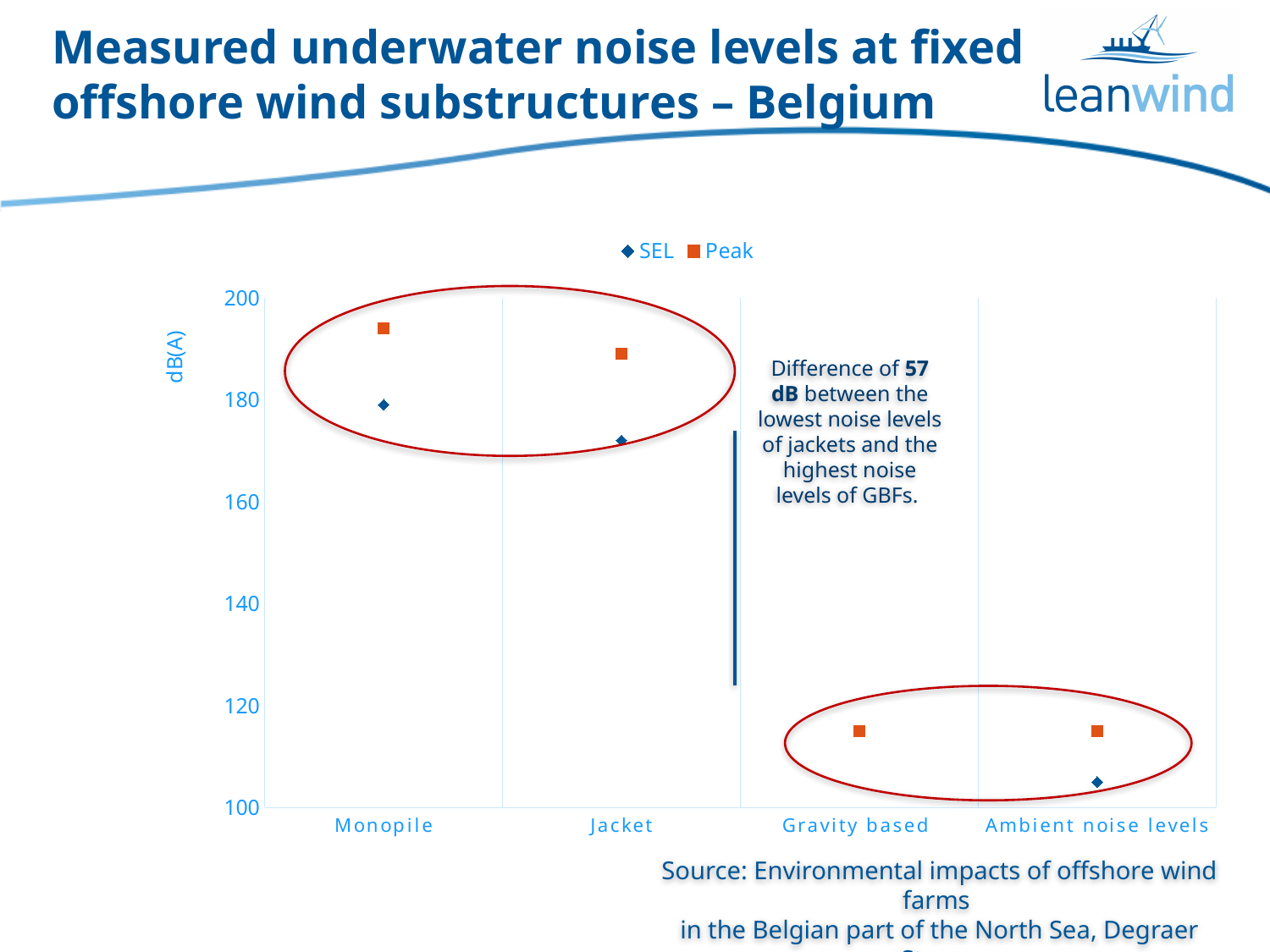
Which category has the highest Peak value? Monopile Which category has the lowest SEL value? Ambient noise levels Is the Peak value for Monopile greater or less than 180? greater Is the Peak value for Gravity based greater or less than 120? less Is the SEL value for Monopile greater or less than 160? greater What is the label on the y axis? dB(A) How many series does the legend list? 2 Which is larger, the Peak value for Monopile or the Peak value for Jacket? Monopile What kind of chart is shown on the slide? scatter chart How many categories are shown on the x axis? 4 What are the two series named in the legend? SEL and Peak